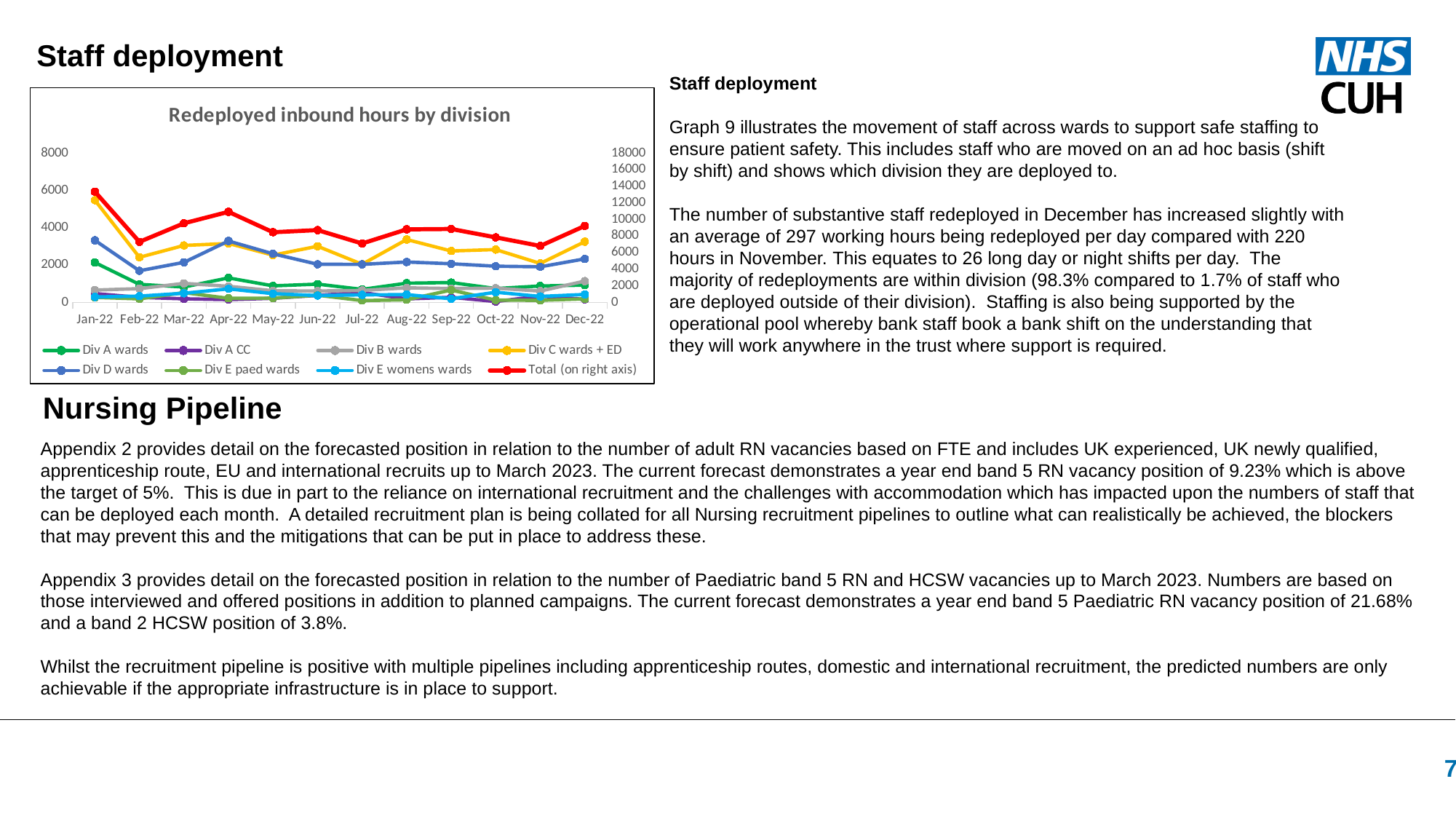
What is the title of the chart on the slide? Redeployed inbound hours by division In Jan-22, which series has the larger value: Div C wards + ED or Div D wards? Div C wards + ED Which series in the "Redeployed inbound hours by division" chart is plotted on the right axis? Total (on right axis) How many months are plotted along the x axis of the "Redeployed inbound hours by division" chart? 12 In which month does the Div C wards + ED series reach its highest value in the "Redeployed inbound hours by division" chart? Jan-22 Is the value for Div C wards + ED in Jan-22 greater or less than 4000 on the left axis? greater In Dec-22, which series has the larger value: Div D wards or Div A wards? Div D wards Does the Total series rise or fall from Jan-22 to Feb-22 in the "Redeployed inbound hours by division" chart? Fall In which month does the Total series reach its highest value in the "Redeployed inbound hours by division" chart? Jan-22 Is the value for Div A wards in Jan-22 greater or less than 4000 on the left axis? less What kind of chart is "Redeployed inbound hours by division"? Line chart How many series does the legend of the "Redeployed inbound hours by division" chart list? 8